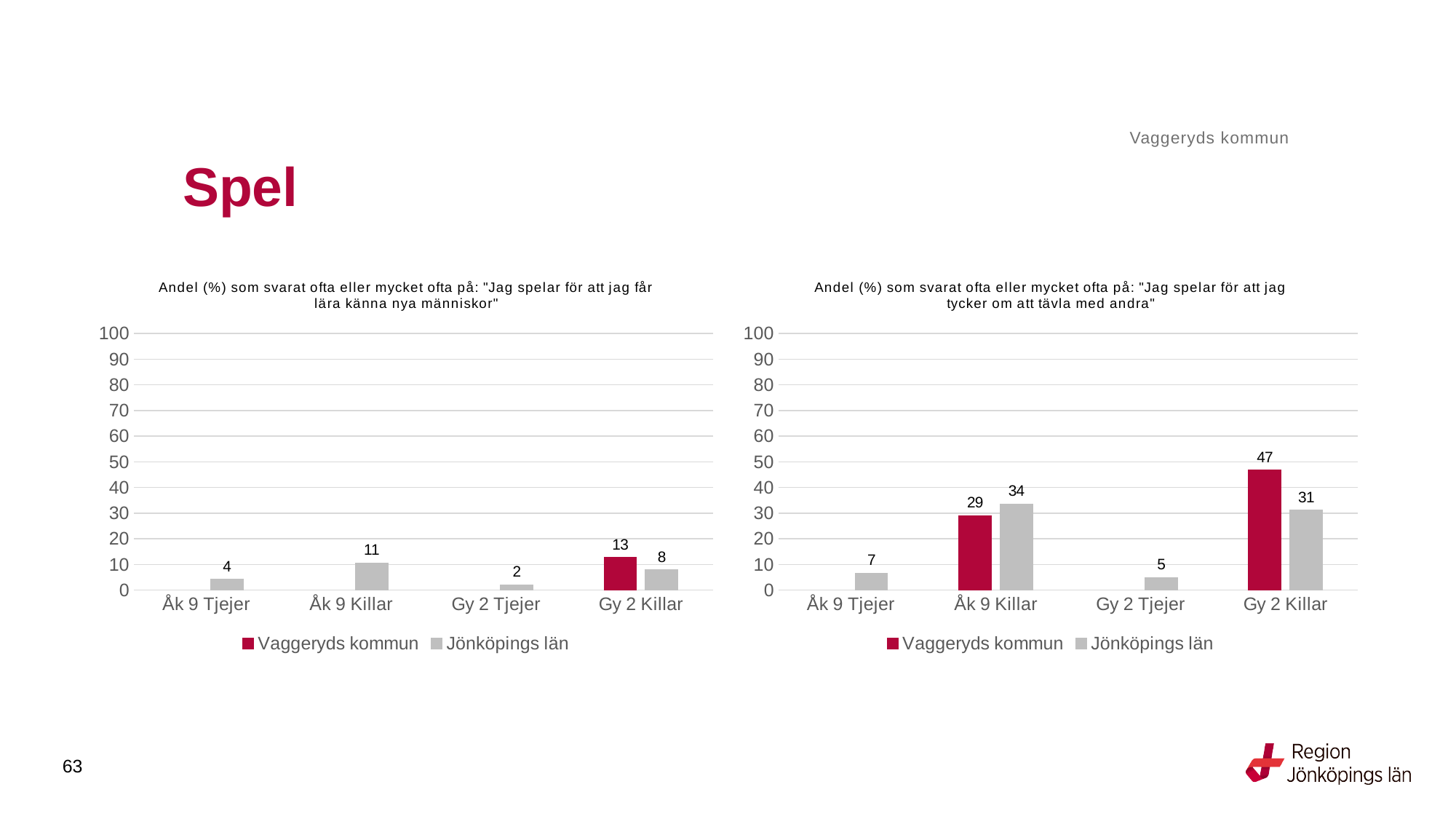
What kind of chart is the right chart? Bar chart In the left chart, which category has the lowest Jönköpings län value? Gy 2 Tjejer In the left chart, what is the value for Jönköpings län for Åk 9 Killar? 11 How many series does the legend of the left chart list? 2 In the right chart, which category has the highest Jönköpings län value? Åk 9 Killar In the left chart, what is the difference between Vaggeryds kommun and Jönköpings län for Gy 2 Killar? 5 In the right chart, which is larger for Åk 9 Killar: Vaggeryds kommun or Jönköpings län? Jönköpings län In the right chart, what is the value for Vaggeryds kommun for Gy 2 Killar? 47 In the left chart, what is the value for Vaggeryds kommun for Gy 2 Killar? 13 In the right chart, what is the difference between Vaggeryds kommun and Jönköpings län for Gy 2 Killar? 16 How many categories are shown on the x axis of the right chart? 4 In the right chart, what is the value for Jönköpings län for Åk 9 Tjejer? 7